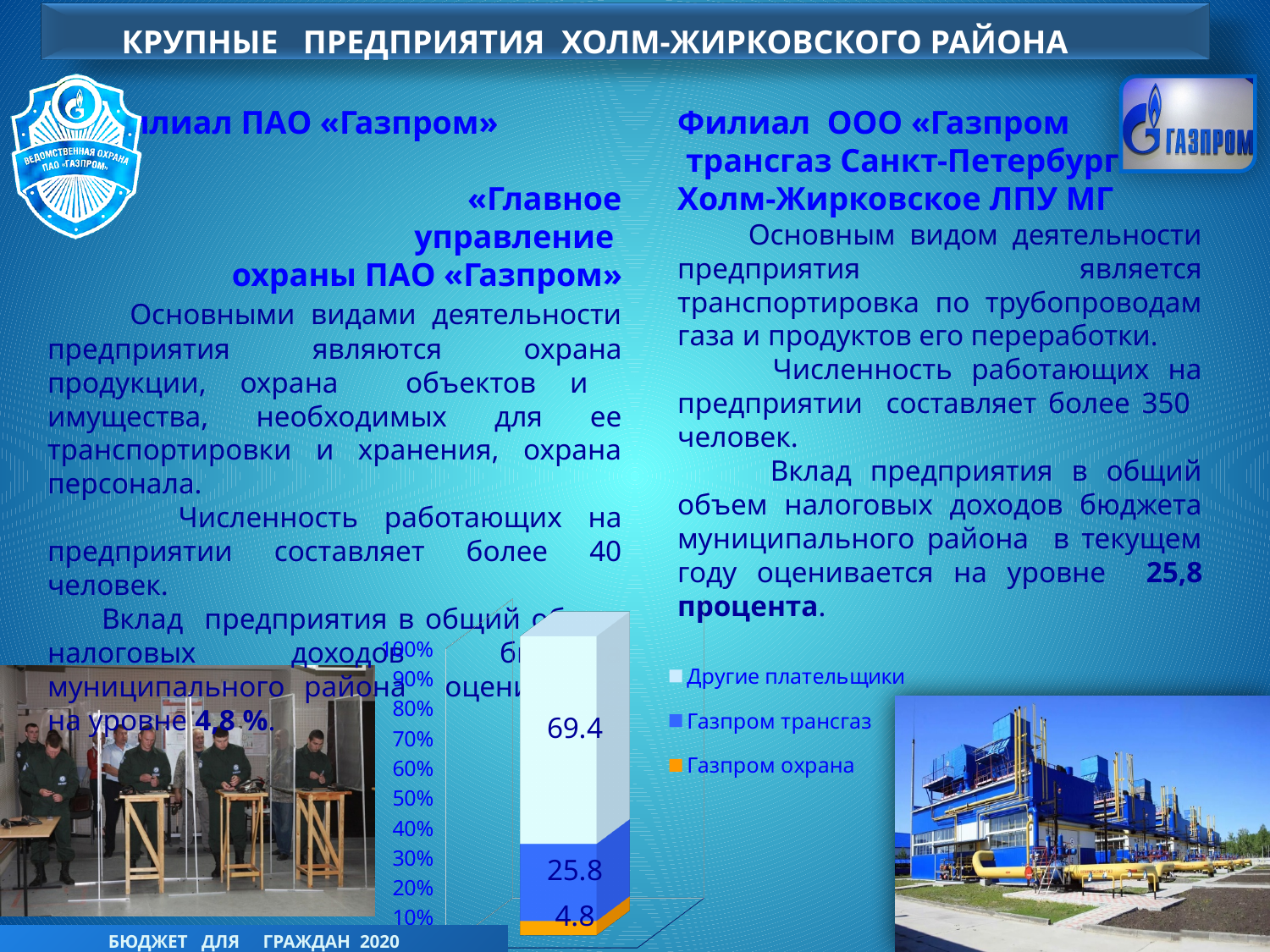
What is the total of the three segments in the stacked bar? 100 Which series has the smallest segment in the stacked bar? Газпром охрана What kind of chart is shown on the slide? Stacked bar chart What is the difference between the Газпром трансгаз segment and the Газпром охрана segment? 21 What is the difference between the Другие плательщики segment and the Газпром трансгаз segment? 43.6 How many series does the chart legend list? 3 Which series has the largest segment in the stacked bar? Другие плательщики Which is larger, the Газпром трансгаз segment or the Газпром охрана segment? Газпром трансгаз What value is shown for the Газпром охрана segment of the stacked bar? 4.8 What value is shown for the Газпром трансгаз segment of the stacked bar? 25.8 What colour is the Газпром охрана series in the chart legend? Orange What value is shown for the Другие плательщики segment of the stacked bar? 69.4